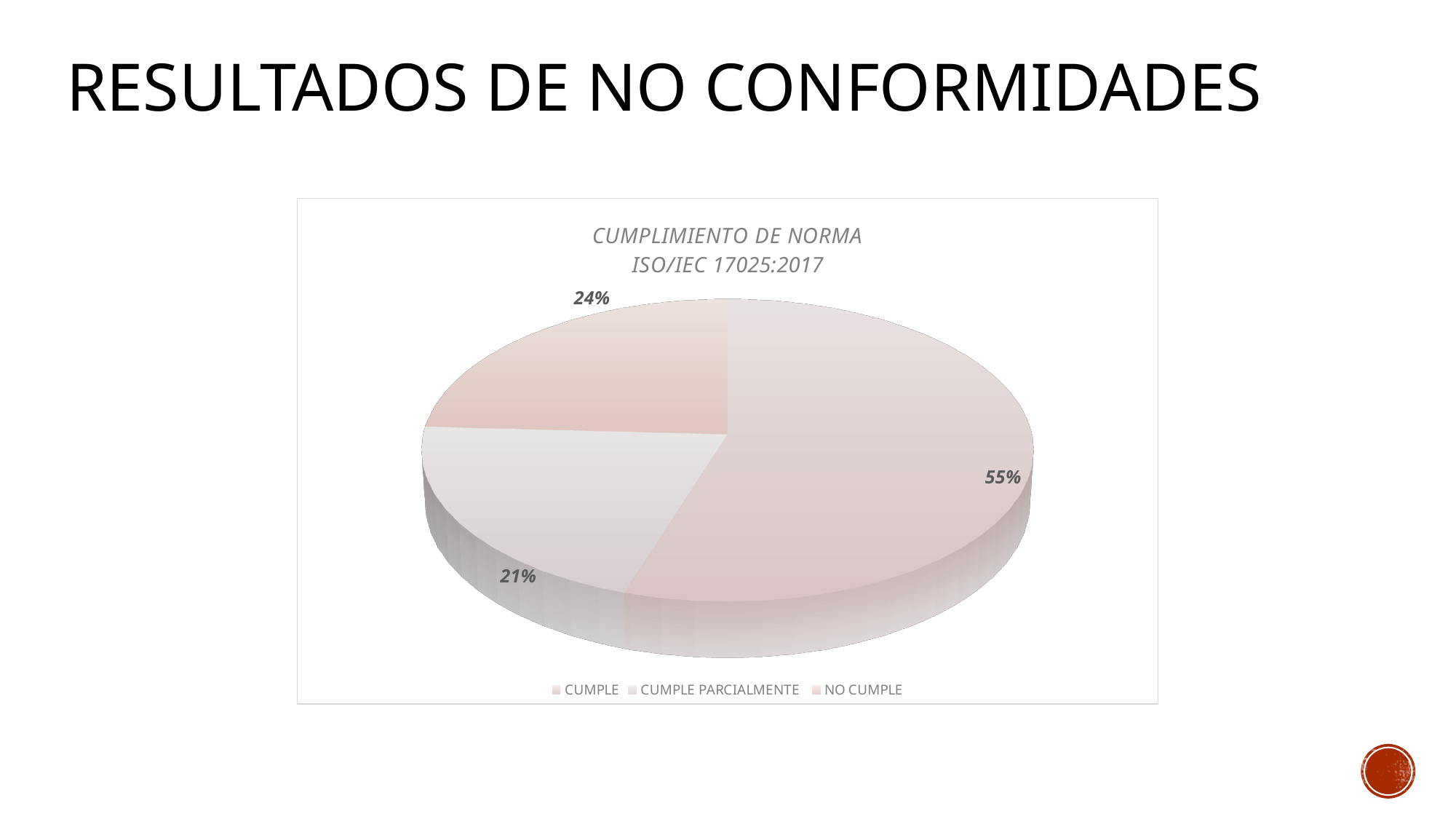
Which is larger, the share for NO CUMPLE or the share for CUMPLE PARCIALMENTE? NO CUMPLE What is the title of the chart? CUMPLIMIENTO DE NORMA ISO/IEC 17025:2017 What share of the pie does CUMPLE represent? 55% Which category has the smallest slice of the pie? CUMPLE PARCIALMENTE Which category has the largest slice of the pie? CUMPLE What are the legend entries of the chart, in order? CUMPLE, CUMPLE PARCIALMENTE, NO CUMPLE What share of the pie does NO CUMPLE represent? 24% What type of chart is shown on the slide? pie chart What is the difference in percentage points between CUMPLE and NO CUMPLE? 31 What share of the pie does CUMPLE PARCIALMENTE represent? 21% What is the difference in percentage points between NO CUMPLE and CUMPLE PARCIALMENTE? 3 How many categories does the legend list? 3